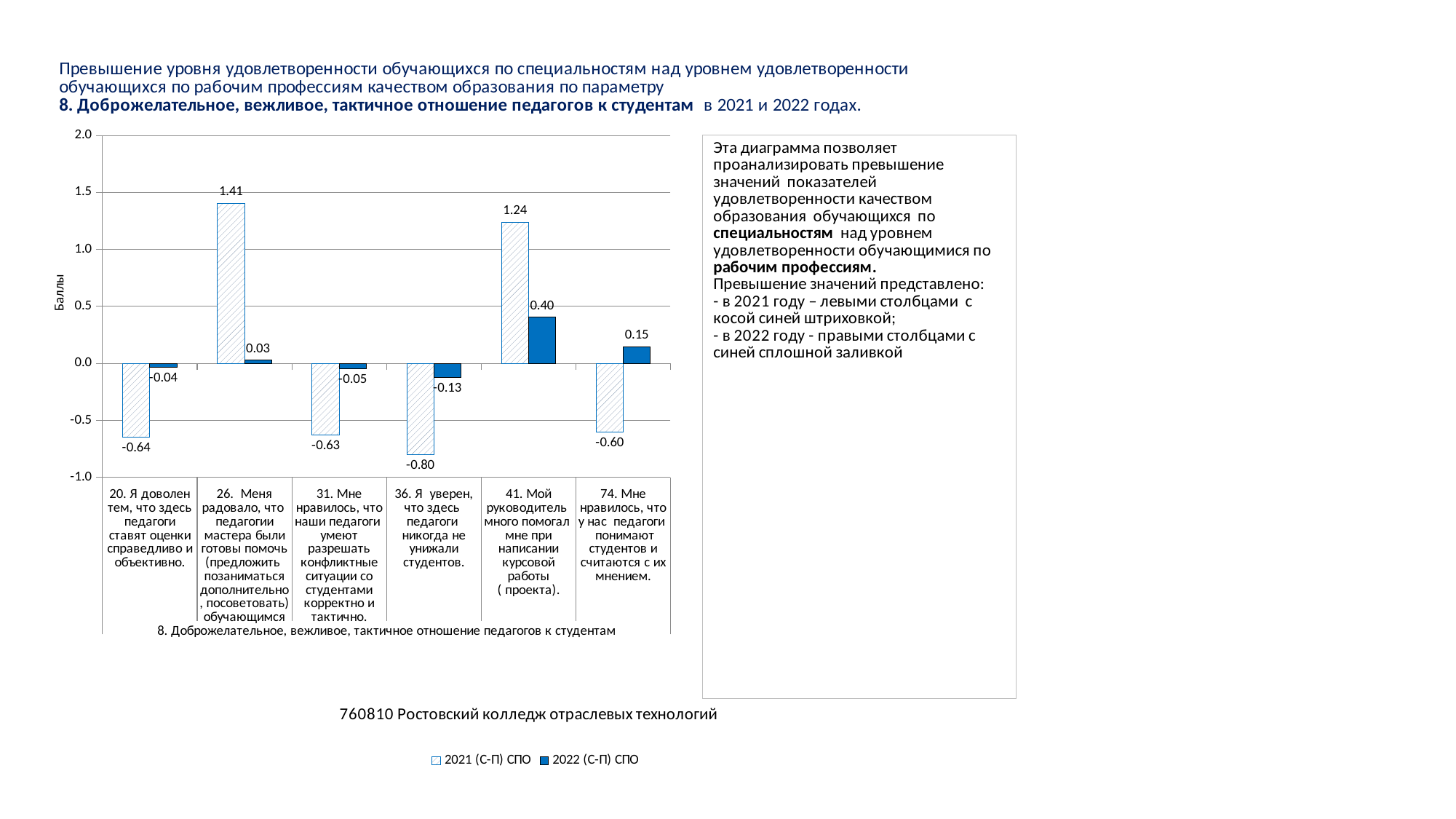
What is the 2022 (С-П) СПО value for item 41 (Мой руководитель много помогал мне при написании курсовой работы)? 0.40 How many items (categories) are shown on the x axis of the chart? 6 Which item has the highest 2021 (С-П) СПО value? 26. Меня радовало, что педагоги мастера были готовы помочь What is the difference between the 2021 and 2022 (С-П) СПО values for item 41? 0.84 What is the 2022 (С-П) СПО value for item 74 (Мне нравилось, что у нас педагоги понимают студентов)? 0.15 What is the 2021 (С-П) СПО value for item 26 (Меня радовало, что педагоги мастера были готовы помочь)? 1.41 Which item has the lowest 2022 (С-П) СПО value? 36. Я уверен, что здесь педагоги никогда не унижали студентов Which item has the lowest 2021 (С-П) СПО value? 36. Я уверен, что здесь педагоги никогда не унижали студентов What is the 2021 (С-П) СПО value for item 36 (Я уверен, что здесь педагоги никогда не унижали студентов)? -0.80 What type of chart is shown on the slide? Bar chart How many series does the chart legend list? 2 For item 20, which series has the larger value: 2021 (С-П) СПО or 2022 (С-П) СПО? 2022 (С-П) СПО